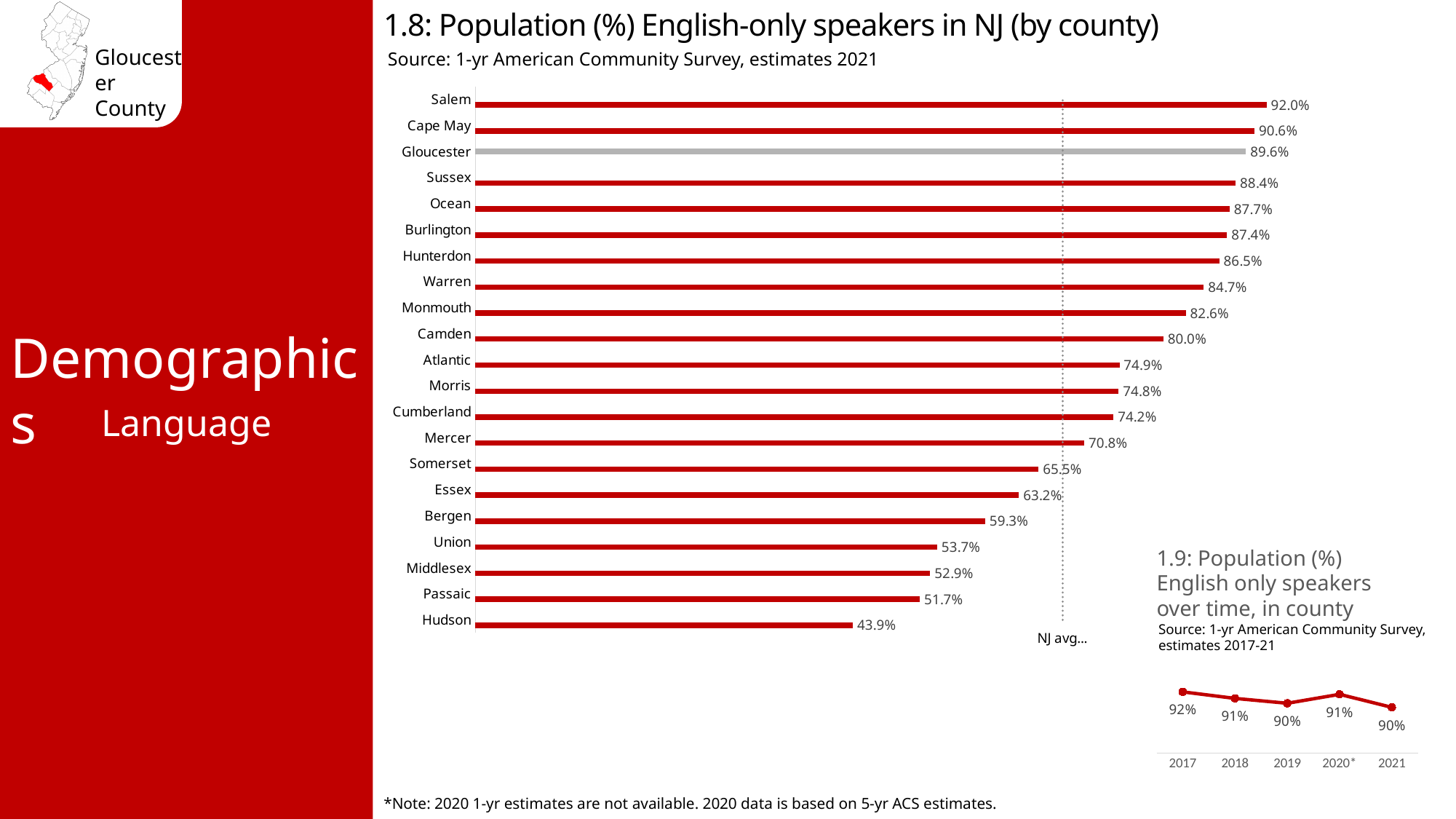
In the chart '1.9: Population (%) English only speakers over time, in county', how many years are plotted? 5 In the chart '1.8: Population (%) English-only speakers in NJ (by county)', what is the difference between Salem and Hudson? 48.1% In the chart '1.8: Population (%) English-only speakers in NJ (by county)', what is the value for Passaic? 51.7% In the chart '1.8: Population (%) English-only speakers in NJ (by county)', which county has the lowest value? Hudson In the chart '1.8: Population (%) English-only speakers in NJ (by county)', what is the value for Camden? 80.0% In the chart '1.9: Population (%) English only speakers over time, in county', what is the value for 2017? 92% In the chart '1.8: Population (%) English-only speakers in NJ (by county)', what is the value for Gloucester? 89.6% In the chart '1.8: Population (%) English-only speakers in NJ (by county)', how many counties are shown? 21 In the chart '1.8: Population (%) English-only speakers in NJ (by county)', which county's bar is coloured grey instead of red? Gloucester In the chart '1.8: Population (%) English-only speakers in NJ (by county)', which is larger, Mercer or Somerset? Mercer In the chart '1.8: Population (%) English-only speakers in NJ (by county)', which county has the highest value? Salem What kind of chart is '1.8: Population (%) English-only speakers in NJ (by county)'? Bar chart